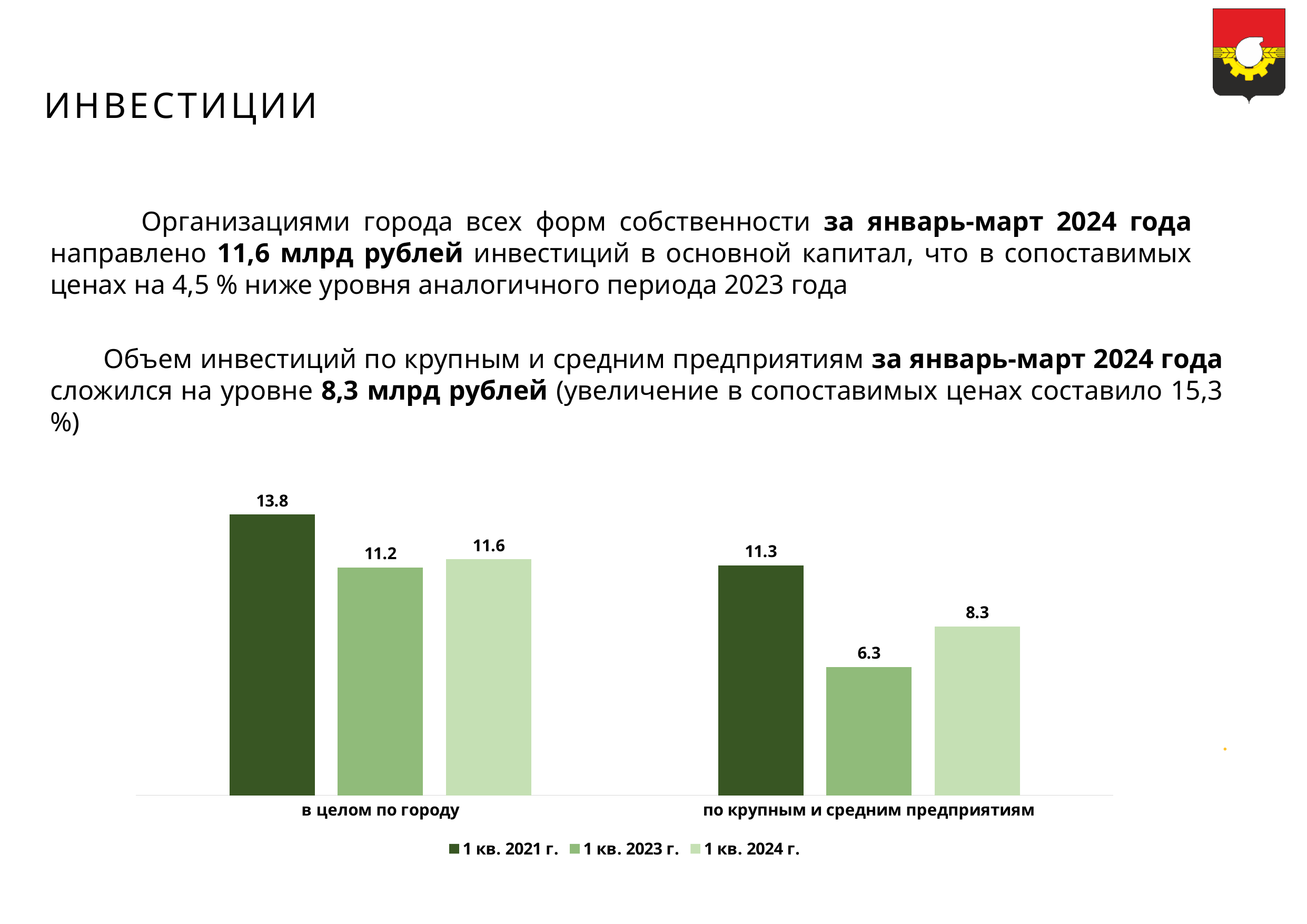
What is the value for 1 кв. 2021 г. in the category 'по крупным и средним предприятиям'? 11.3 How many categories are shown on the x axis of the chart? 2 What is the difference between the 1 кв. 2024 г. and 1 кв. 2023 г. values in the category 'по крупным и средним предприятиям'? 2.0 What is the value for 1 кв. 2021 г. in the category 'в целом по городу'? 13.8 What is the value for 1 кв. 2023 г. in the category 'по крупным и средним предприятиям'? 6.3 What kind of chart is shown on the slide? Bar chart What is the value for 1 кв. 2024 г. in the category 'в целом по городу'? 11.6 How many series does the legend list? 3 Which series has the lowest value in the category 'по крупным и средним предприятиям'? 1 кв. 2023 г. Which is larger: the 1 кв. 2023 г. value for 'в целом по городу' or the 1 кв. 2021 г. value for 'по крупным и средним предприятиям'? 1 кв. 2021 г. value for 'по крупным и средним предприятиям' Which series has the highest value in the category 'в целом по городу'? 1 кв. 2021 г. What is the difference between the 1 кв. 2021 г. and 1 кв. 2024 г. values in the category 'в целом по городу'? 2.2